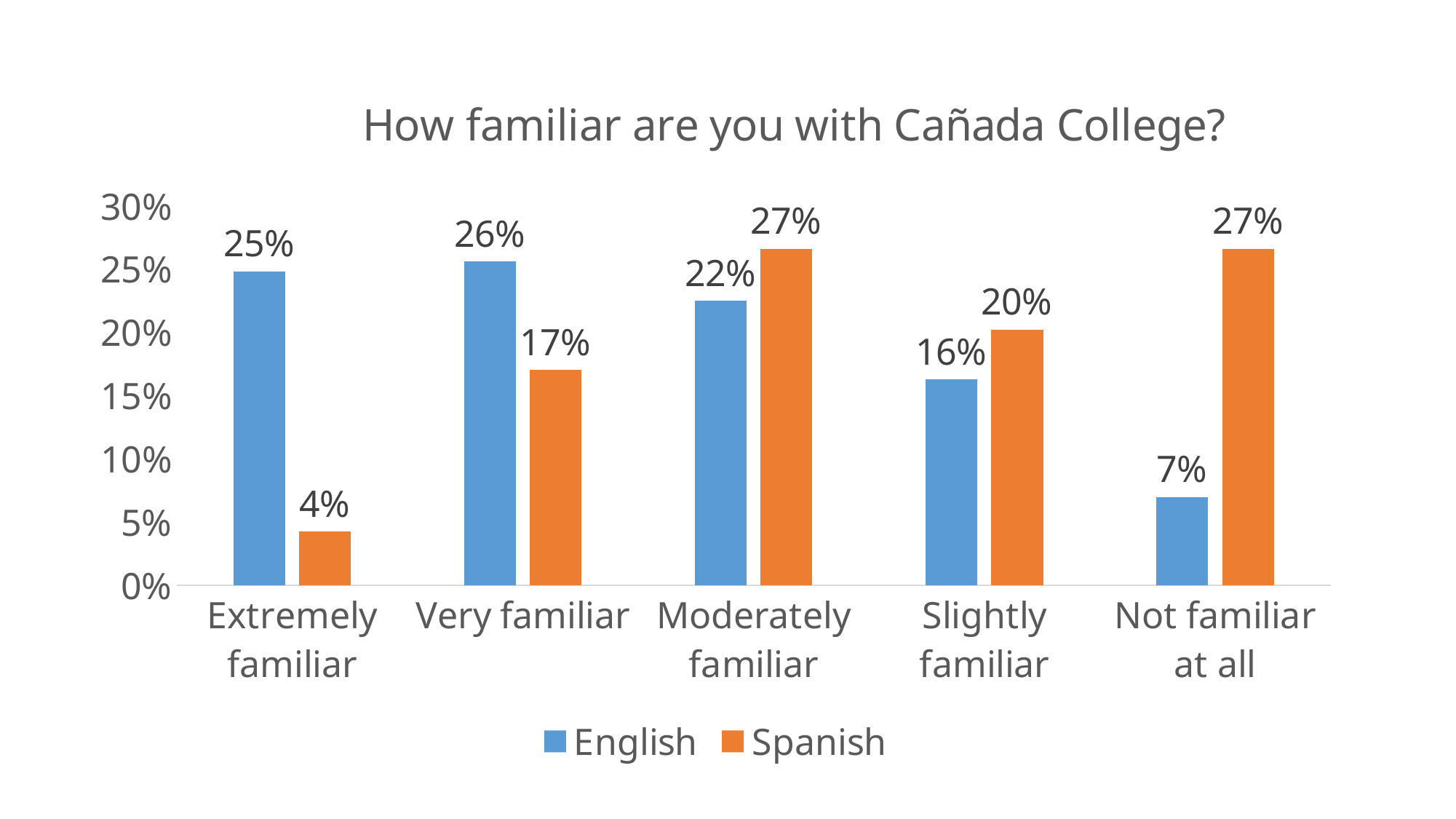
What percentage of English respondents are extremely familiar with Cañada College? 25% What is the Spanish value for the 'Very familiar' category? 17% Which category has the lowest value for the Spanish series? Extremely familiar What is the difference between the Spanish and English values for 'Not familiar at all'? 20% How many categories are shown on the x axis? 5 What is the difference between the English and Spanish values for 'Extremely familiar'? 21% How many series does the legend list? 2 For 'Moderately familiar', which series has the larger value, English or Spanish? Spanish What kind of chart is shown on the slide? Bar chart Which category has the lowest value for the English series? Not familiar at all For 'Slightly familiar', which series has the larger value, English or Spanish? Spanish What percentage of Spanish respondents are not familiar at all with Cañada College? 27%